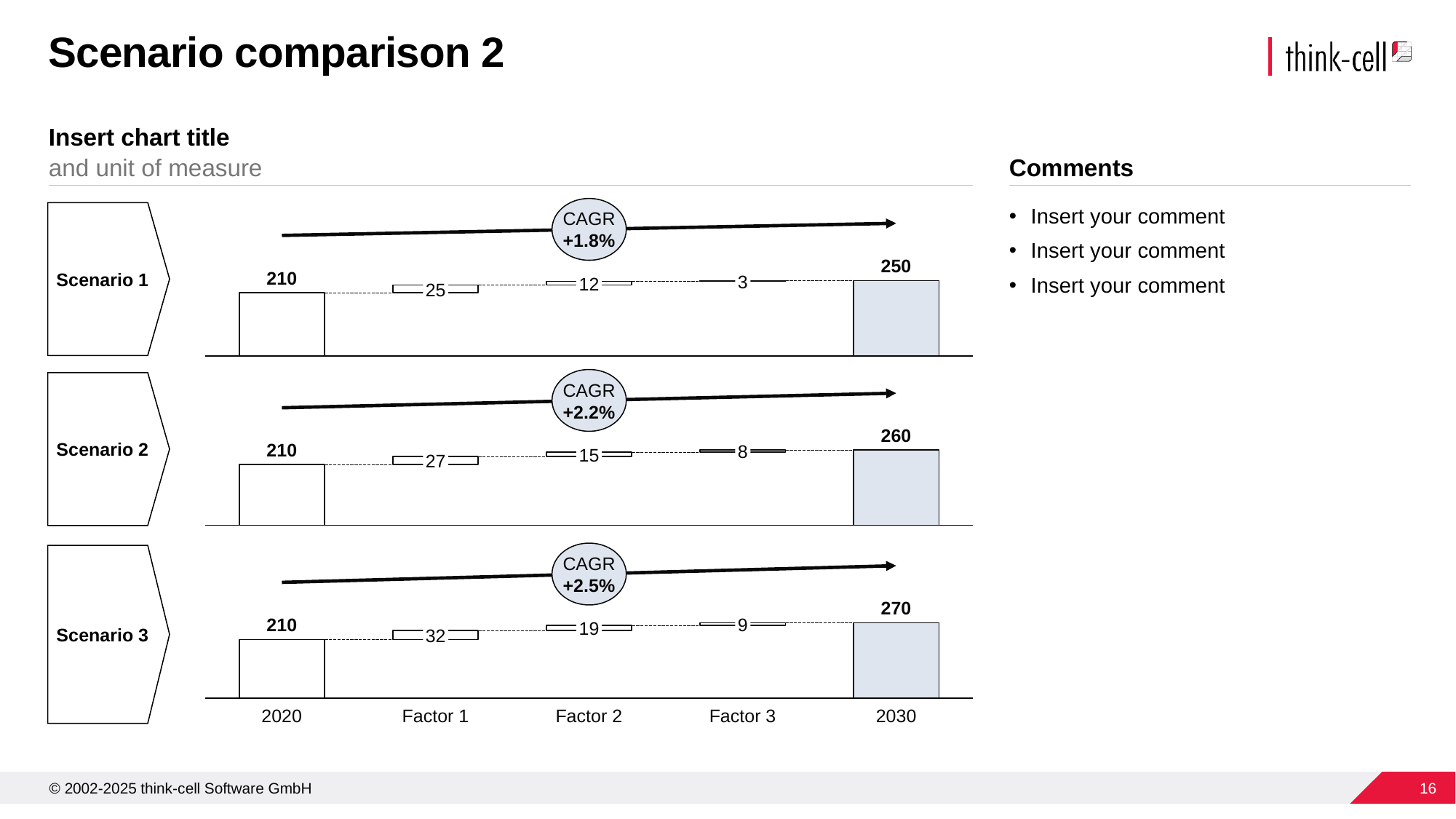
Is the Factor 1 value in the Scenario 3 chart larger or smaller than the Factor 1 value in the Scenario 1 chart? larger In the Scenario 1 chart, what is the value for 2030? 250 In the Scenario 3 chart, what is the value for Factor 2? 19 In the Scenario 1 chart, what is the difference between the 2030 value and the 2020 value? 40 In the Scenario 2 chart, which of the three factors has the smallest value? Factor 3 In the Scenario 1 chart, what is the value for Factor 3? 3 What kind of chart is used for each scenario on this slide? Waterfall chart In the Scenario 3 chart, what is the value for 2030? 270 In the Scenario 3 chart, which of the three factors has the largest value? Factor 1 How many categories are shown on the x axis of the Scenario 2 chart? 5 What CAGR is shown above the Scenario 2 chart? +2.2% In the Scenario 2 chart, what is the value for Factor 1? 27